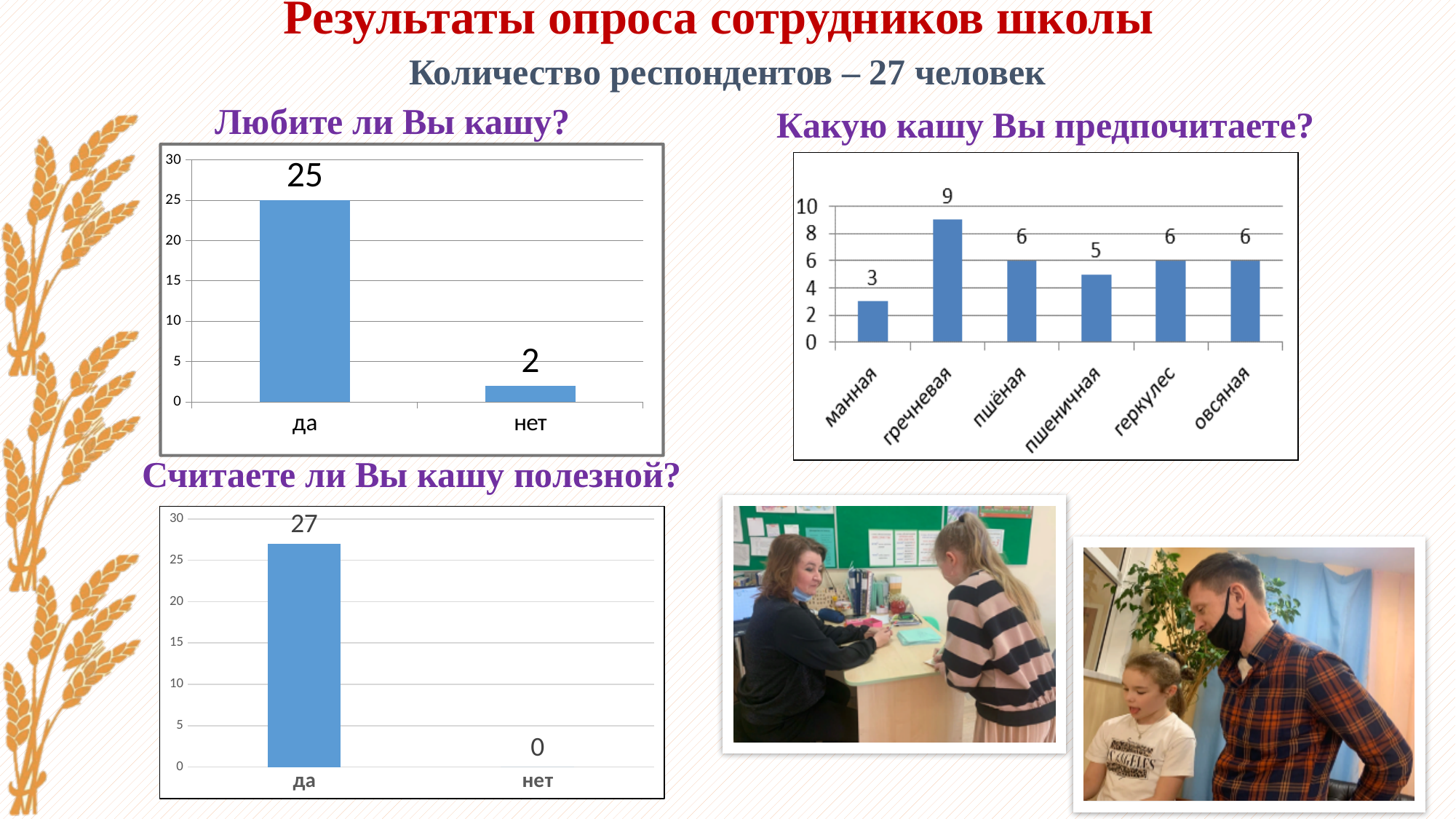
In the chart 'Любите ли Вы кашу?', what is the value for 'да'? 25 In the chart 'Любите ли Вы кашу?', what is the difference between 'да' and 'нет'? 23 In the chart 'Считаете ли Вы кашу полезной?', what is the value for 'нет'? 0 In the chart 'Какую кашу Вы предпочитаете?', what is the value for 'пшеничная'? 5 In the chart 'Какую кашу Вы предпочитаете?', how many categories are shown? 6 In the chart 'Какую кашу Вы предпочитаете?', which category has the highest value? гречневая In the chart 'Какую кашу Вы предпочитаете?', which is larger, 'гречневая' or 'манная'? гречневая What kind of chart is 'Какую кашу Вы предпочитаете?'? bar chart In the chart 'Считаете ли Вы кашу полезной?', what is the value for 'да'? 27 In the chart 'Какую кашу Вы предпочитаете?', which category has the lowest value? манная In the chart 'Какую кашу Вы предпочитаете?', what is the difference between 'гречневая' and 'пшеничная'? 4 In the chart 'Любите ли Вы кашу?', what is the value for 'нет'? 2